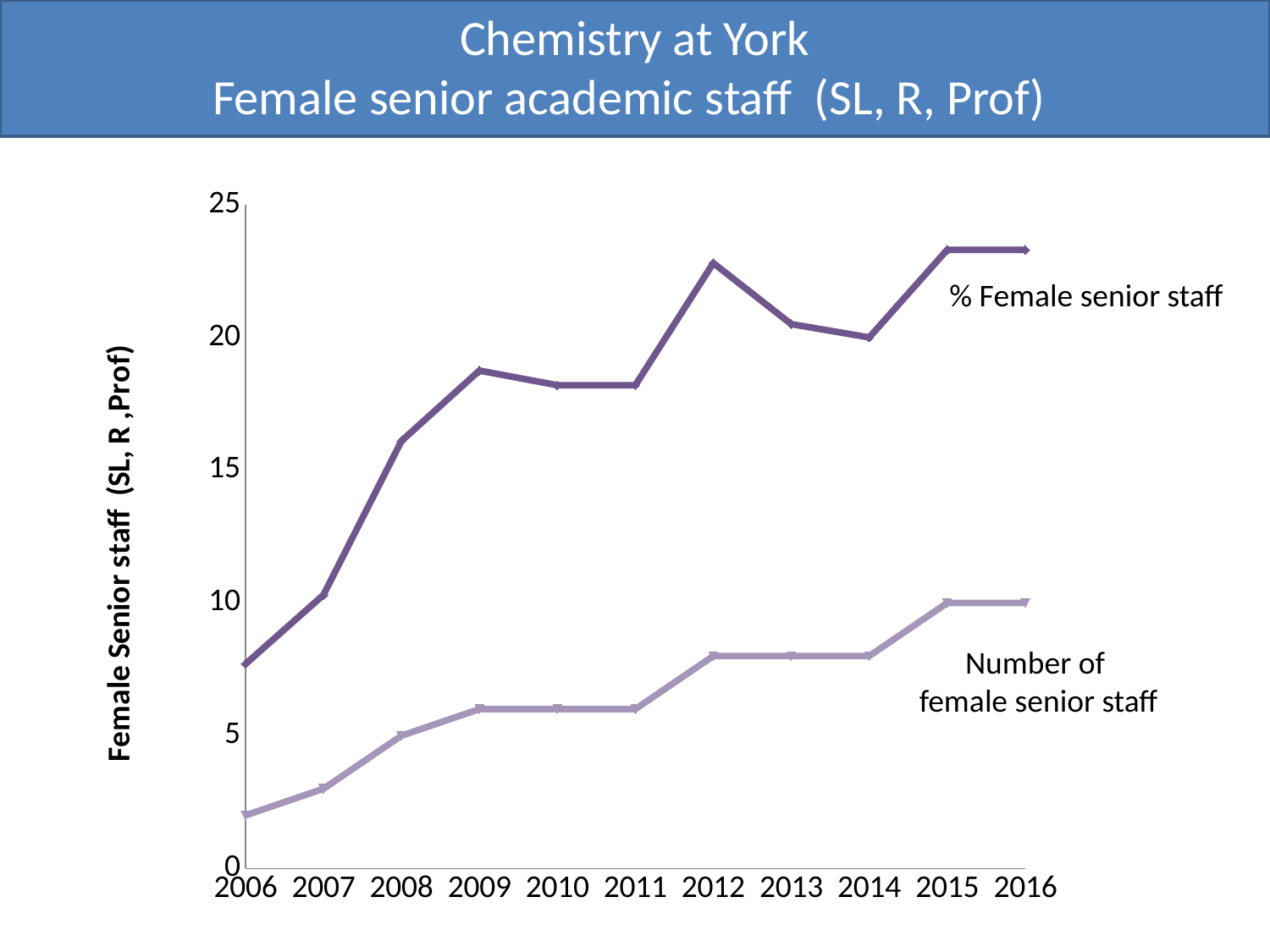
What is the title of the vertical axis of the chart? Female Senior staff (SL, R ,Prof) Which year has the higher value for % Female senior staff, 2012 or 2013? 2012 How many years are shown along the x axis of the chart? 11 What is the value of the Number of female senior staff series in 2015? 10 Does the Number of female senior staff series generally rise or fall from 2006 to 2016? rise In which year is the % Female senior staff series at its lowest? 2006 How many series are plotted on the chart? 2 Is the value for % Female senior staff in 2006 greater or less than 10? less Is the value for % Female senior staff in 2012 greater or less than 20? greater What is the value of the Number of female senior staff series in 2016? 10 What kind of chart is shown on the slide? line chart Is the value for Number of female senior staff in 2012 greater or less than 5? greater